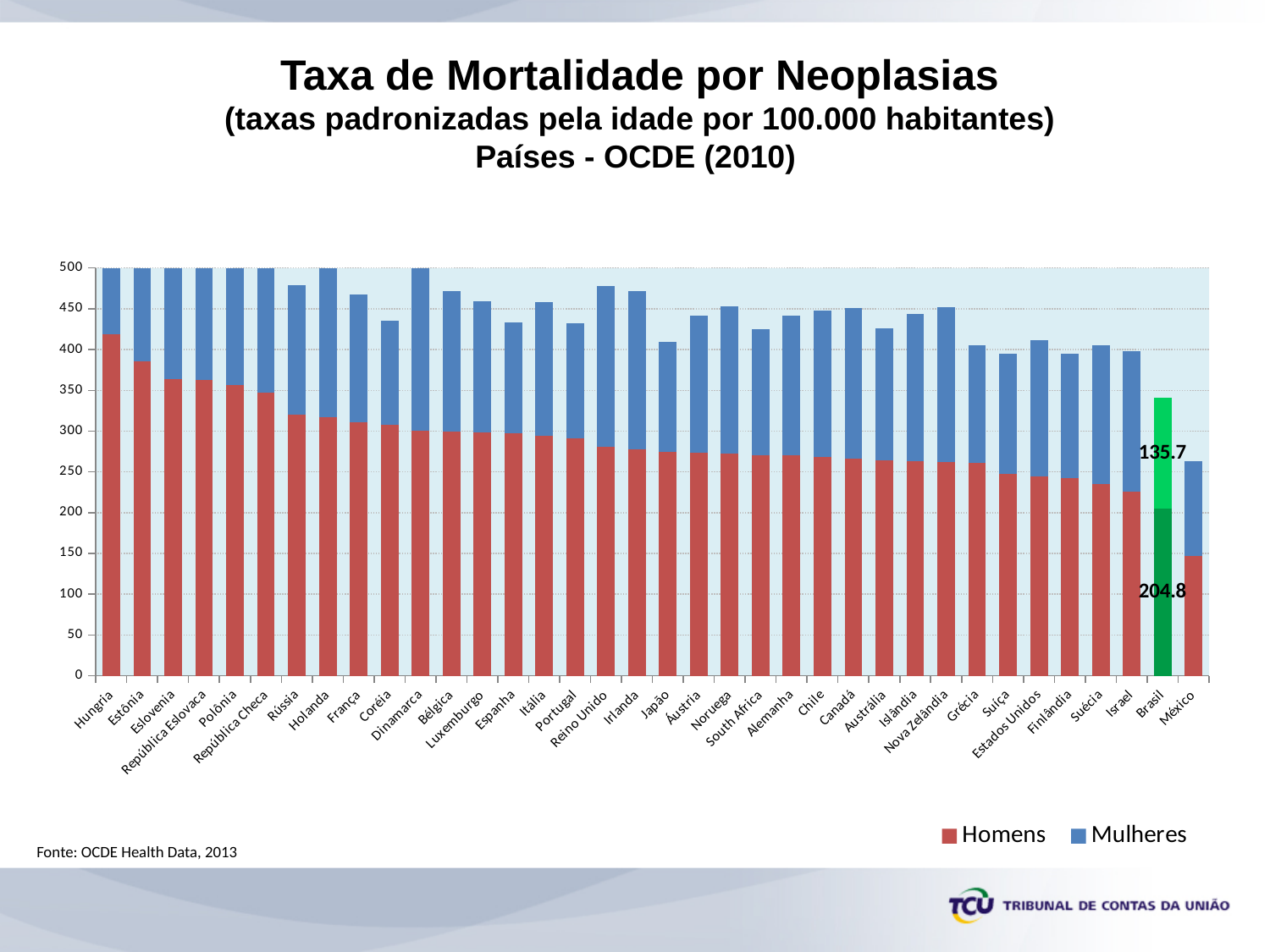
Which country has the lowest Homens value? México For Brasil, which is larger, the Homens value or the Mulheres value? Homens What is the difference between the Homens and Mulheres values for Brasil? 69.1 What is the Mulheres value for Brasil? 135.7 Do the Homens values generally rise or fall from left to right along the x axis? Fall What kind of chart is shown on the slide? Stacked bar chart How many countries are shown on the x axis? 36 What is the total of the stacked bar for Brasil (Homens plus Mulheres)? 340.5 Which country has the highest Homens value? Hungria How many series does the legend list? 2 What is the Homens value for Brasil? 204.8 Is the Homens value for Hungria greater or less than 400? greater